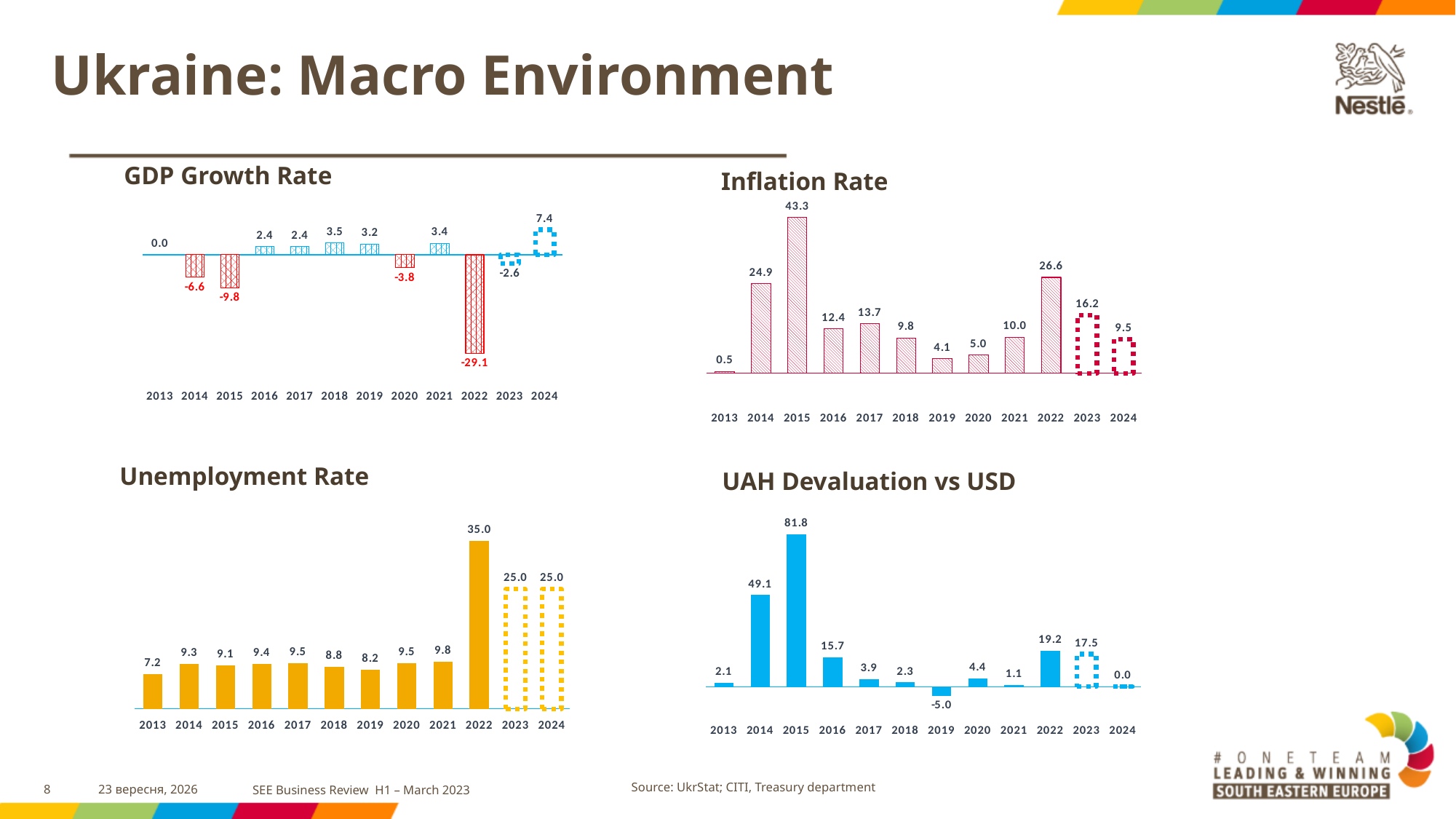
In the UAH Devaluation vs USD chart, what is the difference between the 2014 and 2016 values? 33.4 In the GDP Growth Rate chart, what is the value for 2022? -29.1 In the Inflation Rate chart, which year has the lowest value? 2013 In the GDP Growth Rate chart, which year has the highest value? 2024 In the Inflation Rate chart, what is the value for 2015? 43.3 In the Unemployment Rate chart, what is the value for 2022? 35.0 In the Unemployment Rate chart, which is larger, the value for 2014 or the value for 2015? 2014 What kind of chart is the Inflation Rate chart? Bar chart In the Unemployment Rate chart, how many years are shown on the x axis? 12 In the UAH Devaluation vs USD chart, which year has the highest value? 2015 In the UAH Devaluation vs USD chart, what is the value for 2019? -5.0 In the Inflation Rate chart, what is the difference between the 2022 and 2023 values? 10.4